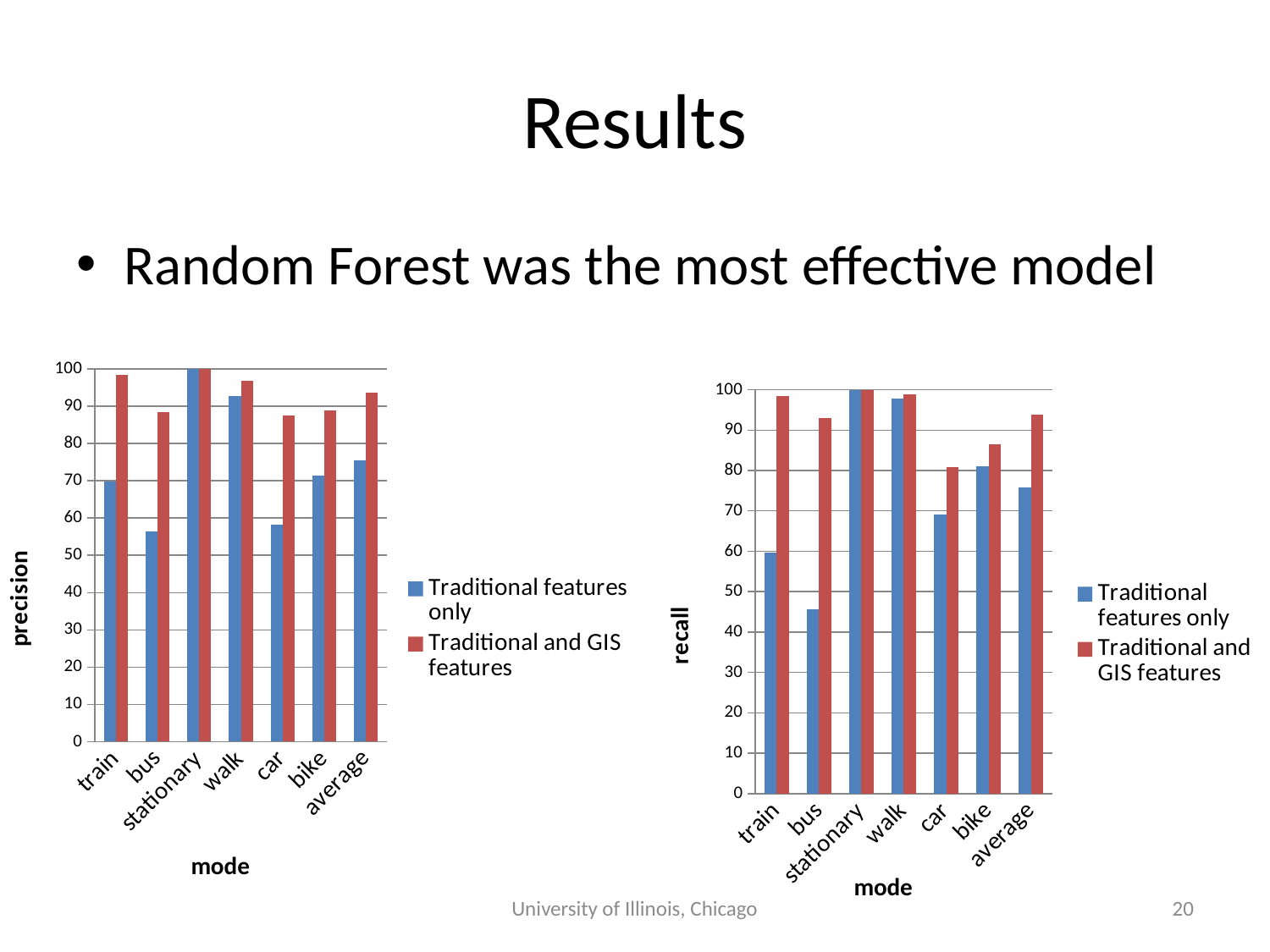
What is the y-axis label of the chart on the right? recall In the recall chart, how many series does the legend list? 2 In the recall chart, is the value for car with Traditional and GIS features greater or less than 90? less In the precision chart, for bus, which series has the larger value: Traditional features only or Traditional and GIS features? Traditional and GIS features What is the x-axis label of the precision chart? mode In the recall chart, is the value for train with Traditional features only greater or less than 50? greater In the precision chart, which mode has the lowest value for Traditional features only? bus In the precision chart, is the value for bike with Traditional features only greater or less than 80? less In the recall chart, which mode has the lowest value for Traditional features only? bus What kind of chart is the precision chart on the left? bar chart In the precision chart, how many modes are shown on the x axis? 7